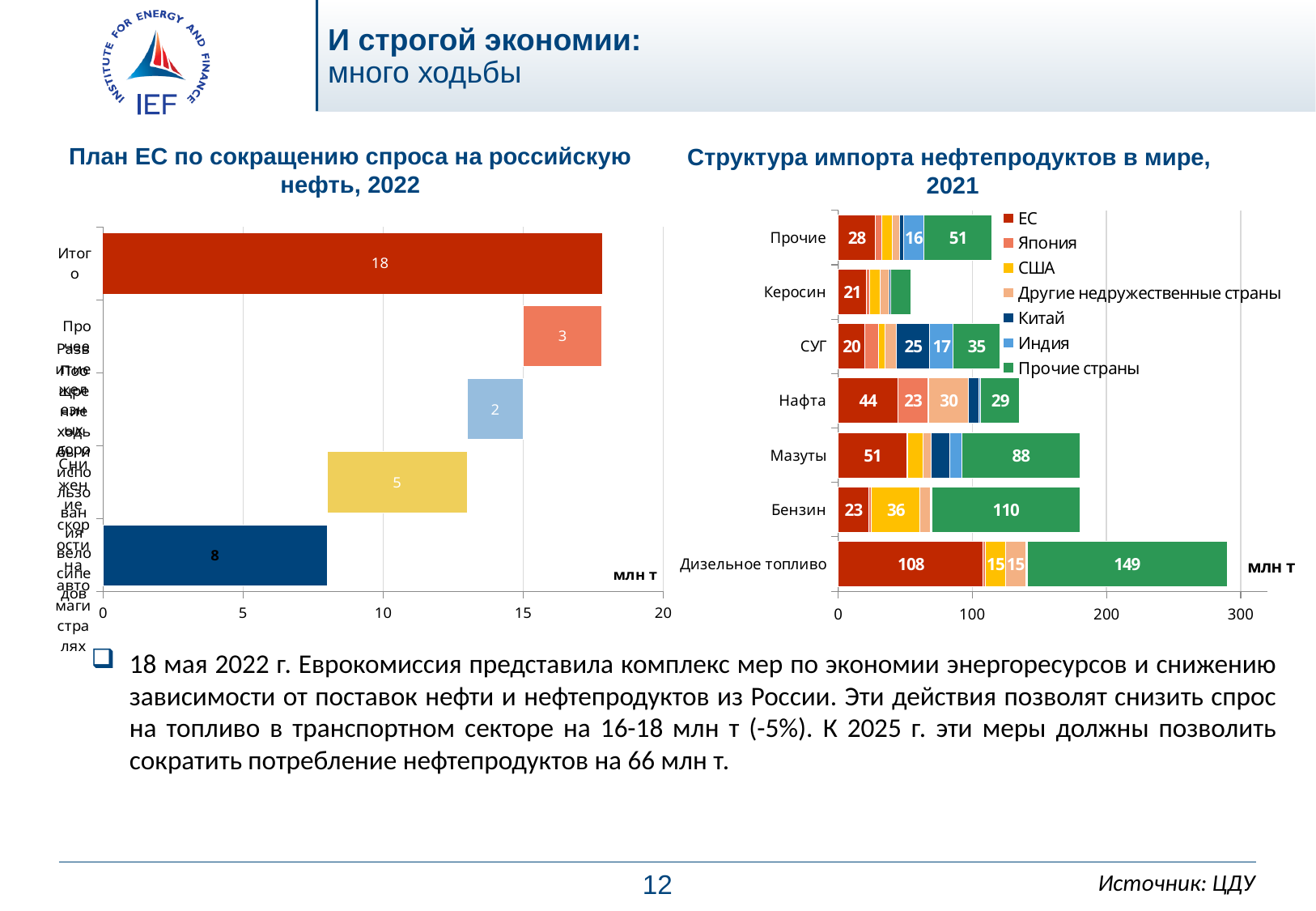
In the chart 'Структура импорта нефтепродуктов в мире, 2021', what is the value of the ЕС segment for Дизельное топливо? 108 In the chart 'Структура импорта нефтепродуктов в мире, 2021', is the total length of the Дизельное топливо bar greater or less than 200? greater What kind of chart is 'План ЕС по сокращению спроса на российскую нефть, 2022'? bar chart In the chart 'Структура импорта нефтепродуктов в мире, 2021', what is the value of the Китай segment for СУГ? 25 In the chart 'Структура импорта нефтепродуктов в мире, 2021', which category has the largest ЕС segment? Дизельное топливо How many categories are shown on the y axis of the chart 'Структура импорта нефтепродуктов в мире, 2021'? 7 In the chart 'Структура импорта нефтепродуктов в мире, 2021', which is larger: the ЕС segment for Мазуты or the ЕС segment for Нафта? Мазуты In the chart 'План ЕС по сокращению спроса на российскую нефть, 2022', what is the value for Итого? 18 How many series does the legend of the chart 'Структура импорта нефтепродуктов в мире, 2021' list? 7 In the chart 'Структура импорта нефтепродуктов в мире, 2021', what is the value of the Прочие страны segment for Бензин? 110 In the chart 'Структура импорта нефтепродуктов в мире, 2021', what is the difference between the Прочие страны segments for Дизельное топливо and Бензин? 39 How many bars are plotted in the chart 'План ЕС по сокращению спроса на российскую нефть, 2022'? 5